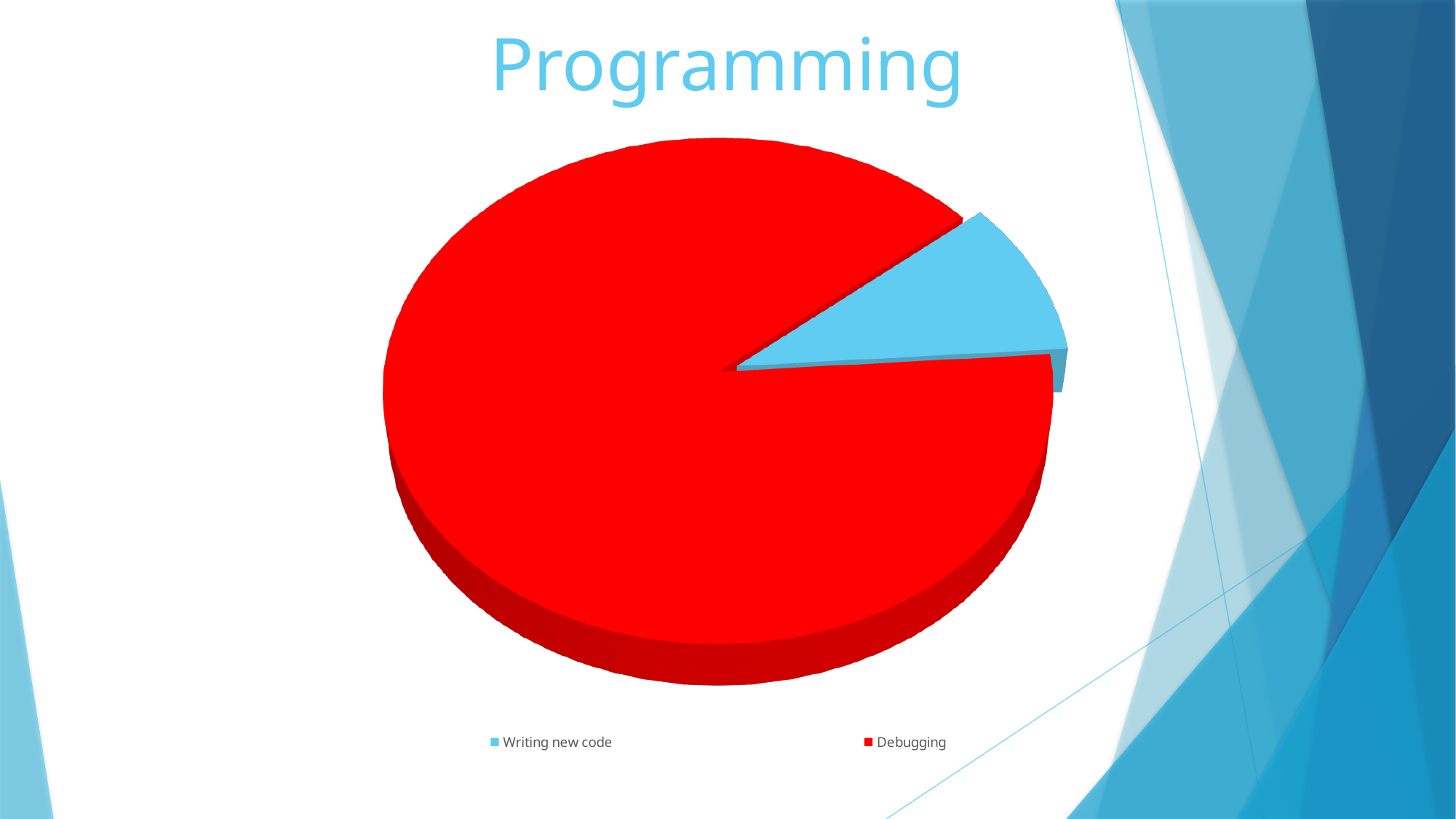
Which category has the smallest slice of the pie? Writing new code How many slices does the pie chart have? 2 What is the title of the chart? Programming What colour is the slice for Writing new code? light blue Is the share of the pie for Writing new code greater or less than 25%? less What kind of chart is shown on the slide? pie chart How many entries does the legend list? 2 Which category has the largest slice of the pie? Debugging Which is larger, the slice for Debugging or the slice for Writing new code? Debugging Is the share of the pie for Debugging greater or less than 50%? greater